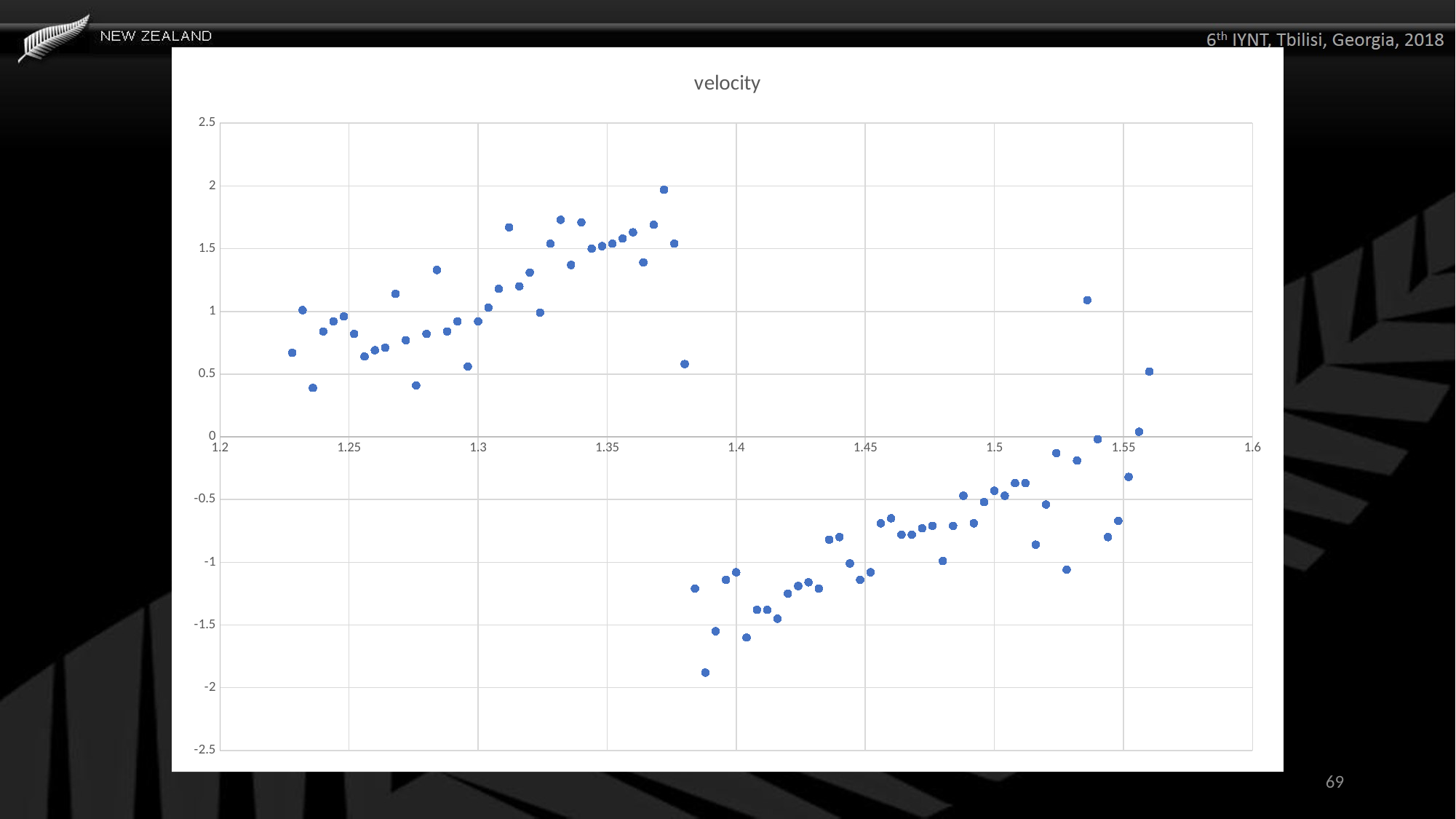
Is the lowest plotted point on the chart greater or less than -1.5? less Which is larger: the highest point near x = 1.37 or the highest point near x = 1.25? the point near x = 1.37 Are the points plotted near x = 1.3 greater or less than 0? greater Between x = 1.4 and x = 1.55, do the plotted values generally rise or fall as x increases? rise Are the points plotted near x = 1.4 greater or less than 0? less What is the title of the chart? velocity What kind of chart is shown on the slide? scatter plot Between x = 1.2 and x = 1.35, do the plotted values generally rise or fall as x increases? rise What is the highest value shown on the y axis of the chart? 2.5